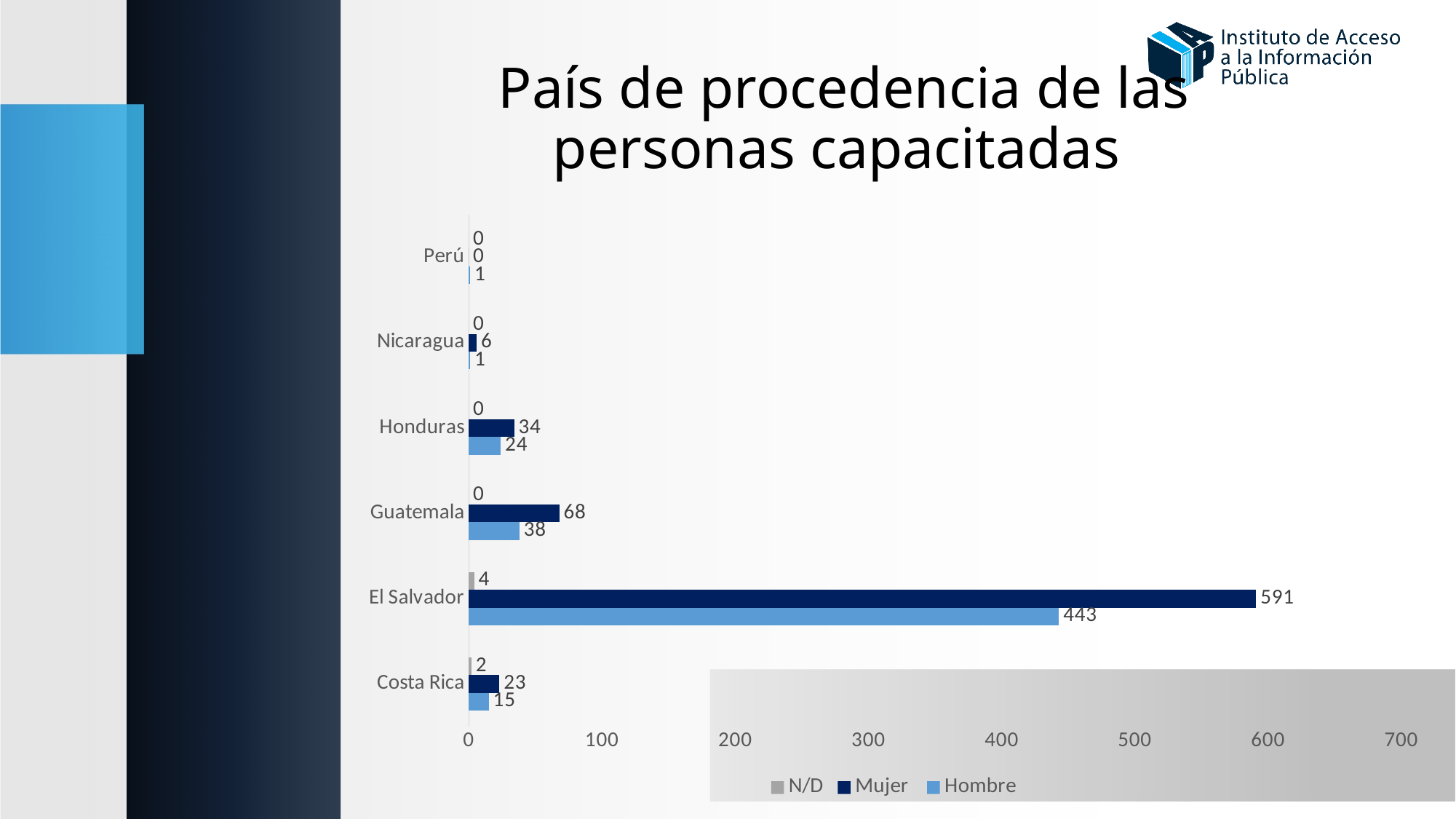
How many countries are shown on the chart? 6 What is the Mujer value for Nicaragua? 6 Which country has the highest Hombre value? El Salvador What kind of chart is shown on the slide? Bar chart What is the N/D value for Costa Rica? 2 What is the difference between the Mujer and Hombre values for El Salvador? 148 What is the Hombre value for Guatemala? 38 Which country has the lowest Mujer value? Perú What is the Mujer value for El Salvador? 591 Which is larger for Honduras, the Mujer value or the Hombre value? Mujer What is the title of the chart? País de procedencia de las personas capacitadas How many series does the legend list? 3